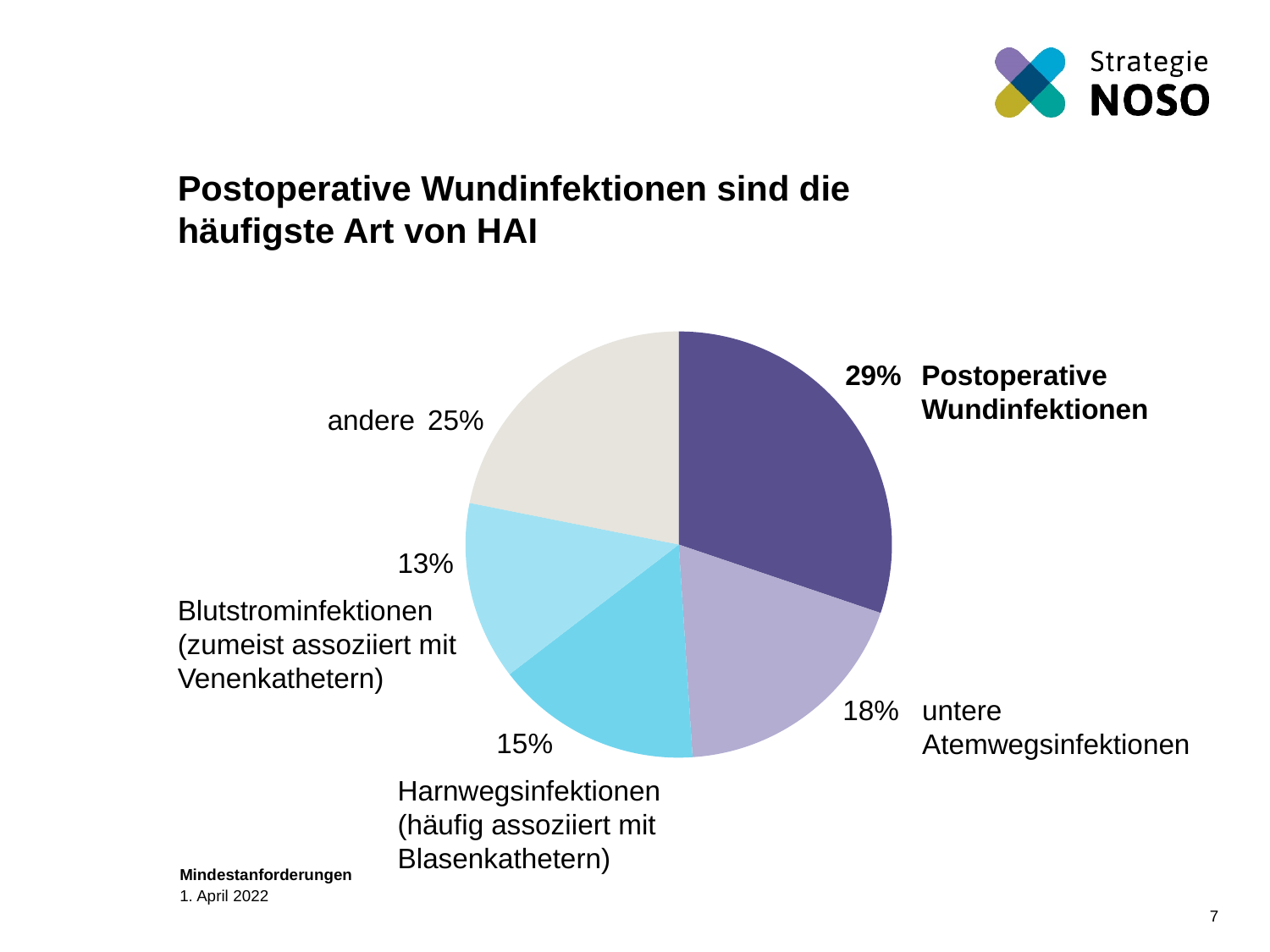
What share of the pie is Postoperative Wundinfektionen? 29% How many slices does the pie chart have? 5 What share of the pie is untere Atemwegsinfektionen? 18% Which category has the smallest slice of the pie? Blutstrominfektionen Which category has the largest slice of the pie? Postoperative Wundinfektionen What share of the pie is Blutstrominfektionen? 13% What kind of chart is shown on the slide? pie chart What is the difference in percentage points between andere and Blutstrominfektionen? 12 Which is larger, the share for andere or the share for Harnwegsinfektionen? andere What is the difference in percentage points between Postoperative Wundinfektionen and untere Atemwegsinfektionen? 11